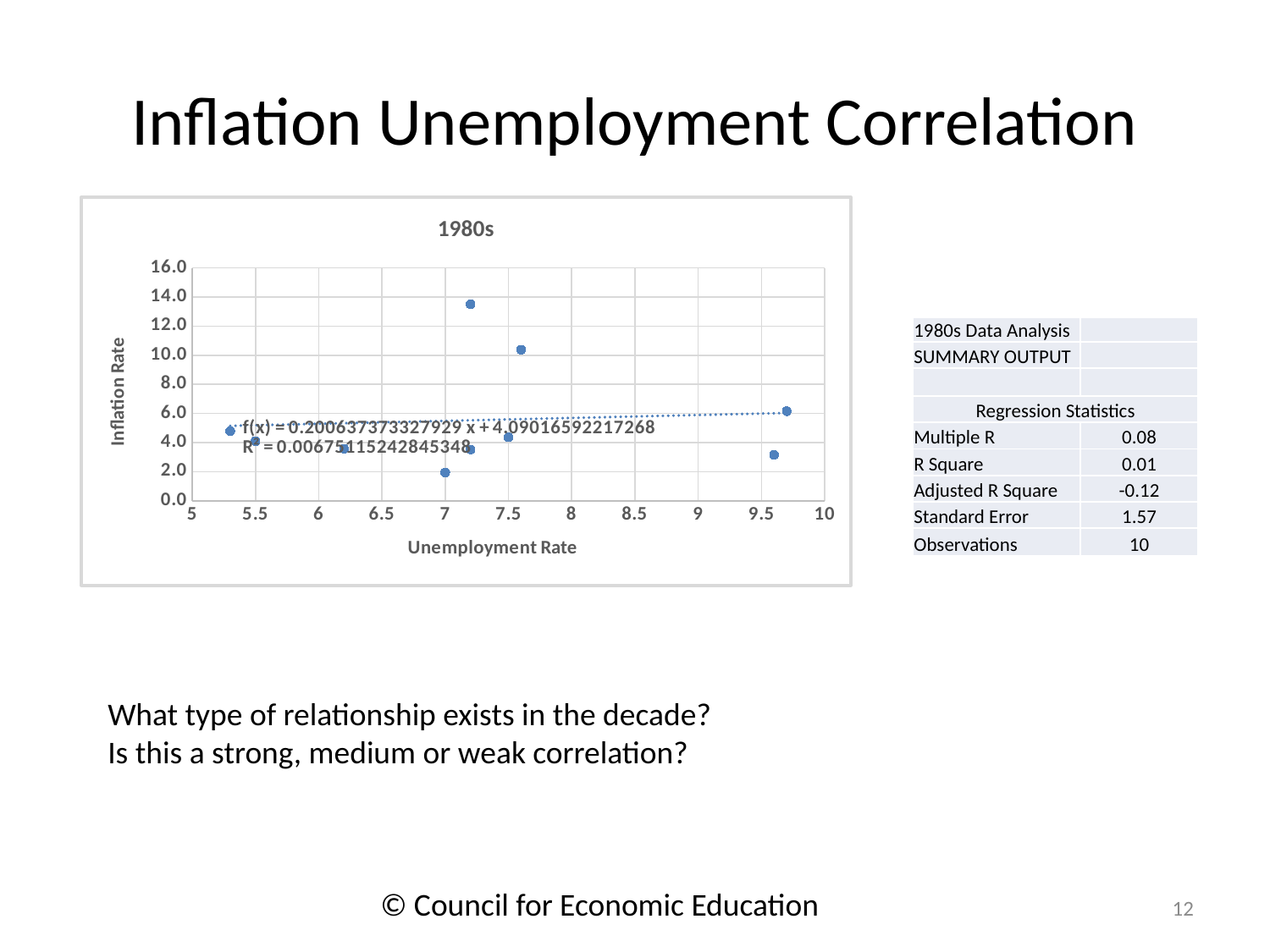
How many data points are plotted on the chart? 10 What is the highest value shown on the y axis of the chart? 16.0 Is the unemployment rate of the leftmost point on the chart greater or less than 5.5? less What is the title of the chart? 1980s Does the dotted trendline on the chart rise or fall as the unemployment rate increases? rise Which has the higher inflation rate: the point at an unemployment rate of about 7.2 near the top of the chart, or the point at about 7.6? The point at about 7.2 Is the inflation rate of the lowest point on the chart greater or less than 4.0? less What kind of chart is shown on the slide? Scatter chart Is the unemployment rate of the rightmost point on the chart greater or less than 9.5? greater What is the label of the x axis of the chart? Unemployment Rate